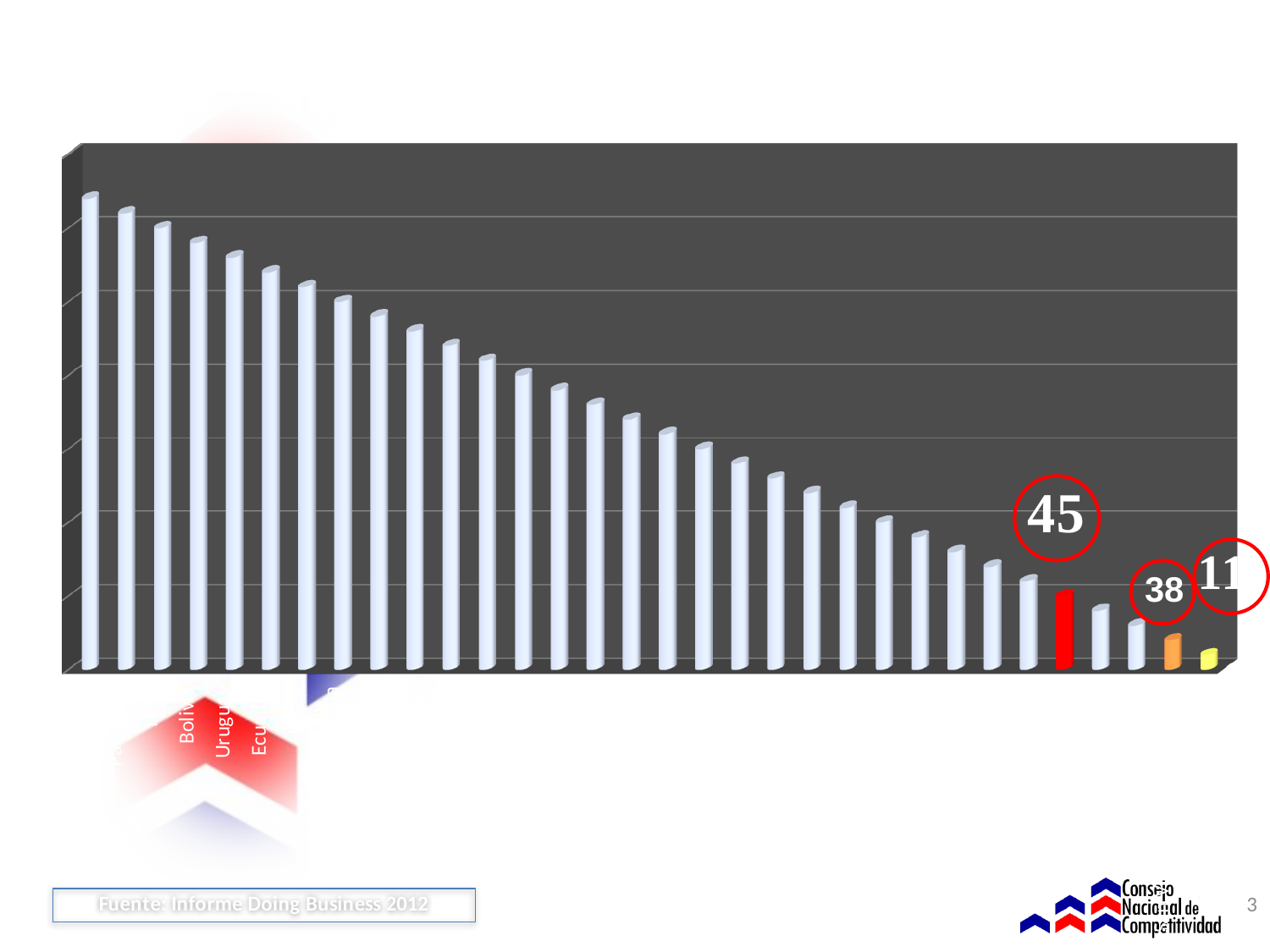
Do the bar values generally rise or fall from left to right across the chart? fall Which is larger, the value of the red bar or the value of the orange bar? the red bar What value is circled above the yellow bar at the far right? 11 What source is cited at the bottom of the slide? Fuente: Informe Doing Business 2012 What is the difference between the value of the red bar (45) and the orange bar (38)? 7 What colour is the bar annotated with the value 45? red What value is circled above the red bar? 45 Which bar has the lowest value in the chart? the yellow bar at the far right What value is circled above the orange bar? 38 What is the difference between the value of the red bar (45) and the yellow bar (11)? 34 What kind of chart is shown on the slide? bar chart What is the difference between the value of the orange bar (38) and the yellow bar (11)? 27